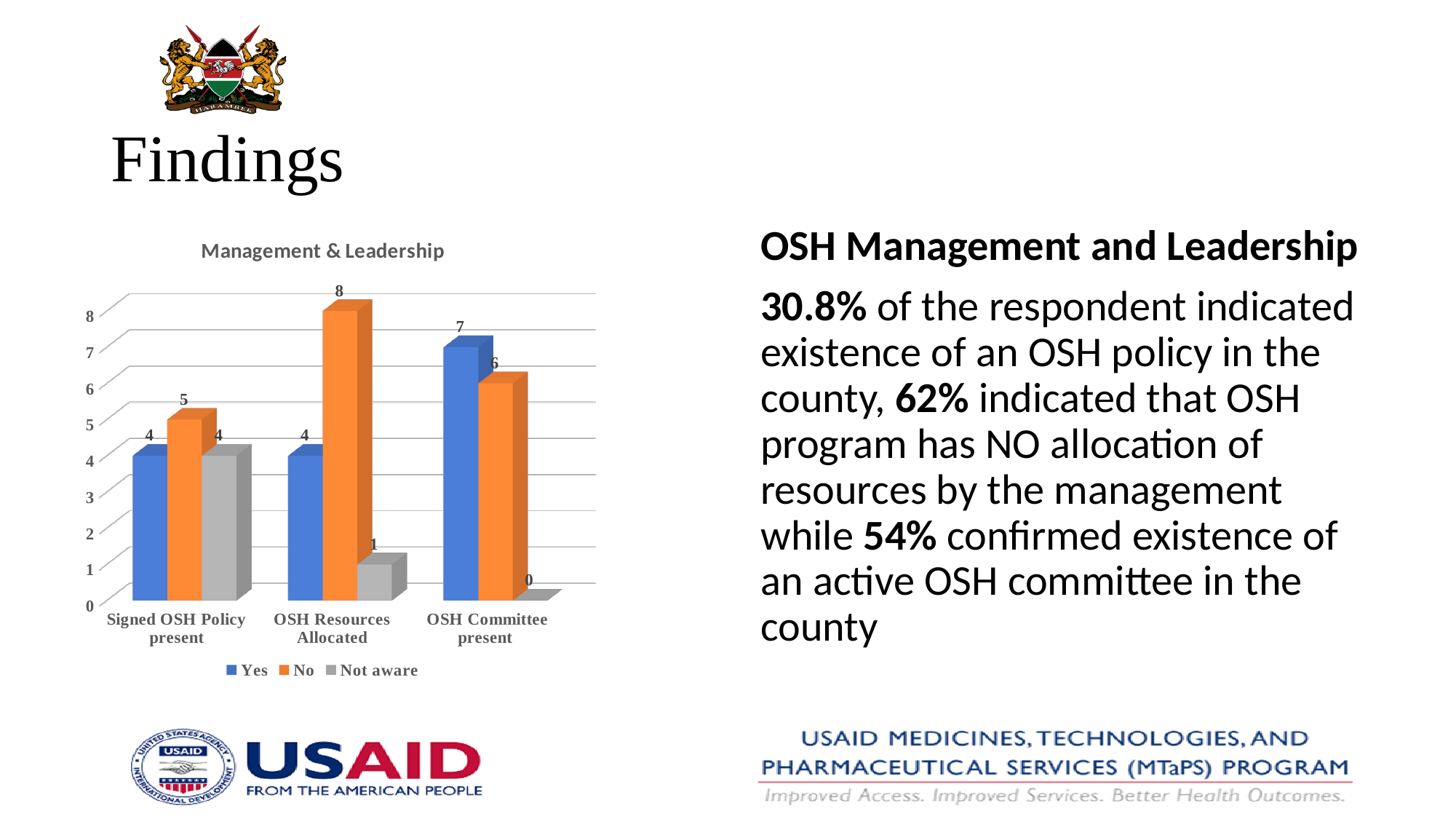
What is the title of the chart? Management & Leadership What is the value for 'No' in the 'OSH Resources Allocated' category? 8 How many series does the legend list? 3 What is the value for 'Yes' in the 'OSH Committee present' category? 7 Which category has the highest 'No' value? OSH Resources Allocated How many categories are shown on the x axis? 3 What is the difference between the 'No' and 'Not aware' values in the 'OSH Resources Allocated' category? 7 What is the value for 'Not aware' in the 'OSH Committee present' category? 0 What type of chart is shown on the slide? bar chart Which category has the lowest 'Not aware' value? OSH Committee present What is the value for 'Not aware' in the 'Signed OSH Policy present' category? 4 In the 'OSH Committee present' category, which is larger, 'Yes' or 'No'? Yes